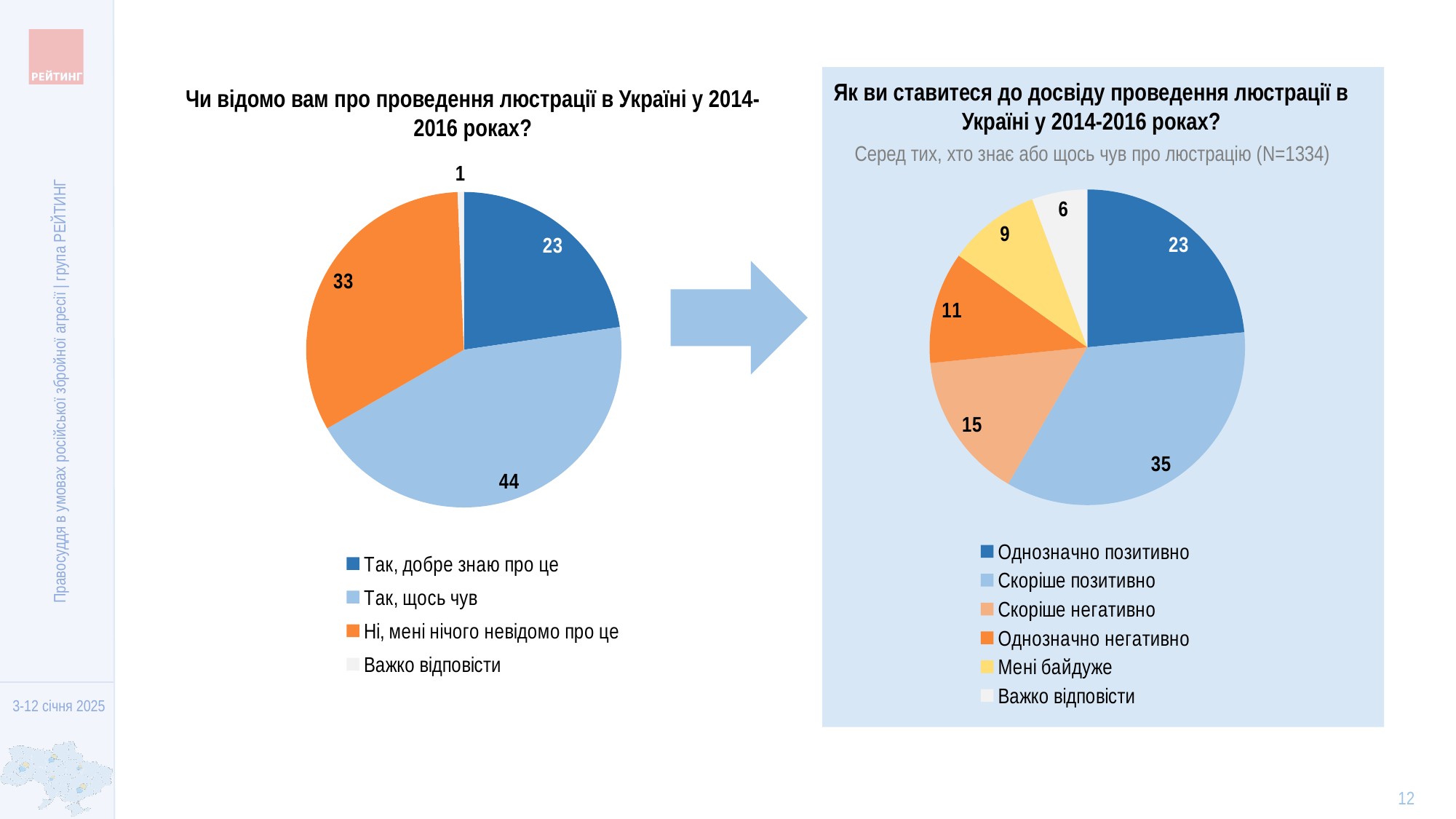
In the right pie chart, which category has the largest slice? Скоріше позитивно What type of chart is shown on the right side of the slide? Pie chart In the left pie chart, what is the difference between "Так, щось чув" and "Так, добре знаю про це"? 21 In the right pie chart, what is the difference between "Однозначно позитивно" and "Важко відповісти"? 17 In the right pie chart, what is the value for "Однозначно негативно"? 11 In the right pie chart, which is larger: "Скоріше негативно" or "Мені байдуже"? Скоріше негативно How many categories does the legend of the left pie chart list? 4 In the right pie chart, what is the value for "Скоріше позитивно"? 35 How many categories does the legend of the right pie chart list? 6 In the left pie chart, which category has the smallest slice? Важко відповісти In the left pie chart, what is the value for "Ні, мені нічого невідомо про це"? 33 In the left pie chart, what is the value for "Так, щось чув"? 44